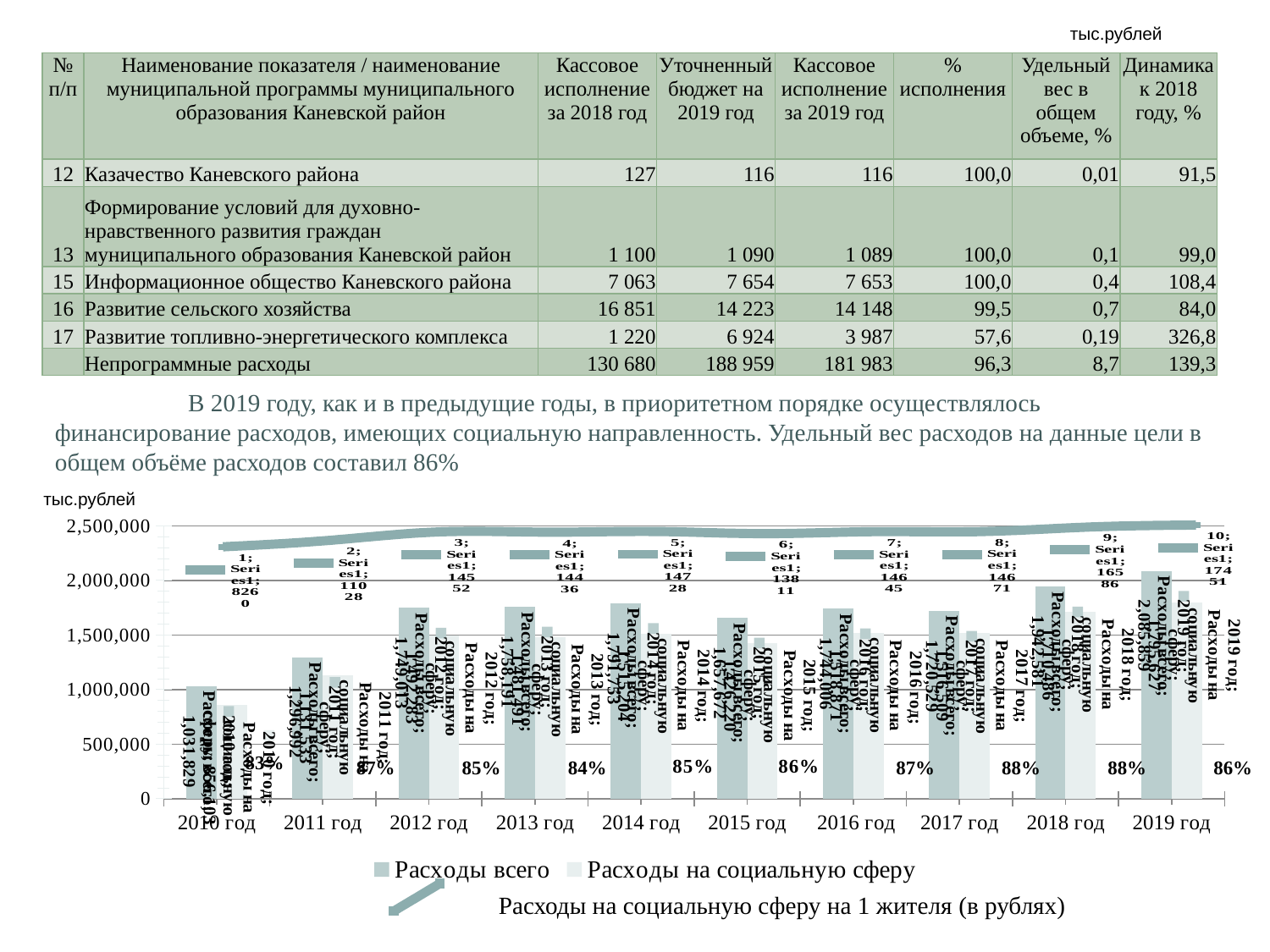
Do the values of 'Расходы всего' generally rise or fall from 2010 год to 2019 год? rise Is the value of 'Расходы всего' for 2019 год greater or less than 2,000,000? greater What is the value of 'Расходы всего' for 2019 год? 2,085,859 How many years (categories) are shown on the x axis of the chart? 10 What is the value of 'Расходы всего' for 2010 год? 1,031,829 Which is larger, 'Расходы всего' for 2018 год or for 2019 год? 2019 год How many series does the chart legend list? 3 Which year has the highest value for 'Расходы всего'? 2019 год Is the value of 'Расходы всего' for 2010 год greater or less than 1,500,000? less Which year has the lowest value for 'Расходы всего'? 2010 год What kind of chart is shown at the bottom of the slide? bar chart (with a line series) What percentage label is shown for 2019 год in the chart? 86%